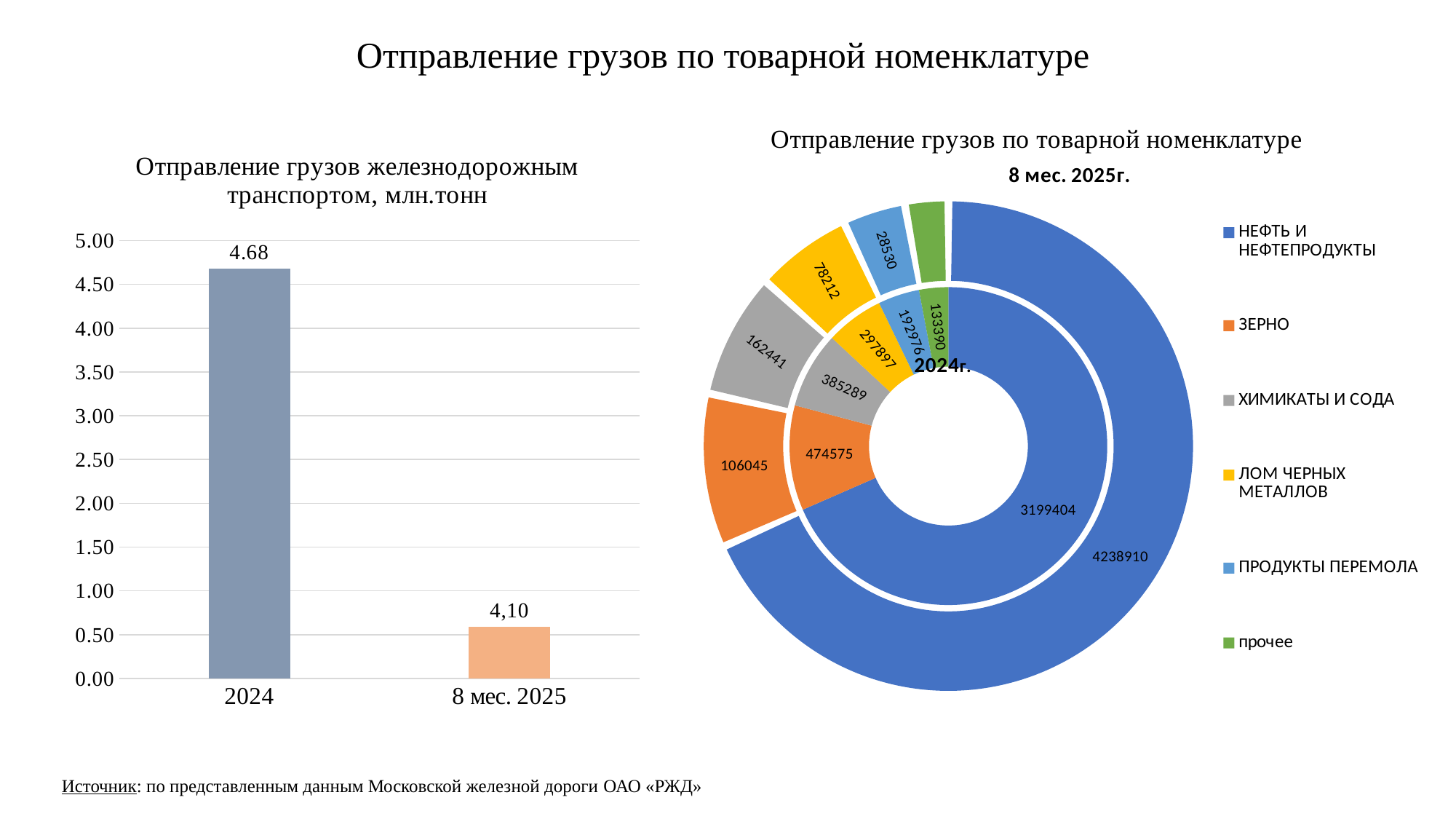
In the doughnut chart on the right, what is the value for НЕФТЬ И НЕФТЕПРОДУКТЫ in the inner ring (2024г.)? 3199404 In the bar chart on the left, what value is labelled for 8 мес. 2025? 4,10 How many categories are shown in the bar chart on the left? 2 In the bar chart on the left, which category has the higher value, 2024 or 8 мес. 2025? 2024 In the bar chart on the left, what is the value for 2024? 4.68 In the doughnut chart on the right, what is the value for ЛОМ ЧЕРНЫХ МЕТАЛЛОВ in the outer ring (8 мес. 2025г.)? 78212 How many entries does the legend of the doughnut chart on the right list? 6 In the doughnut chart on the right, what is the difference between ЗЕРНО and ХИМИКАТЫ И СОДА in the inner ring (2024г.)? 89286 In the doughnut chart on the right, which category has the largest value in the inner ring (2024г.)? НЕФТЬ И НЕФТЕПРОДУКТЫ What kind of chart is the chart on the left? bar chart What kind of chart is the chart on the right, 'Отправление грузов по товарной номенклатуре'? doughnut chart In the doughnut chart on the right, which category has the smallest value in the inner ring (2024г.)? прочее